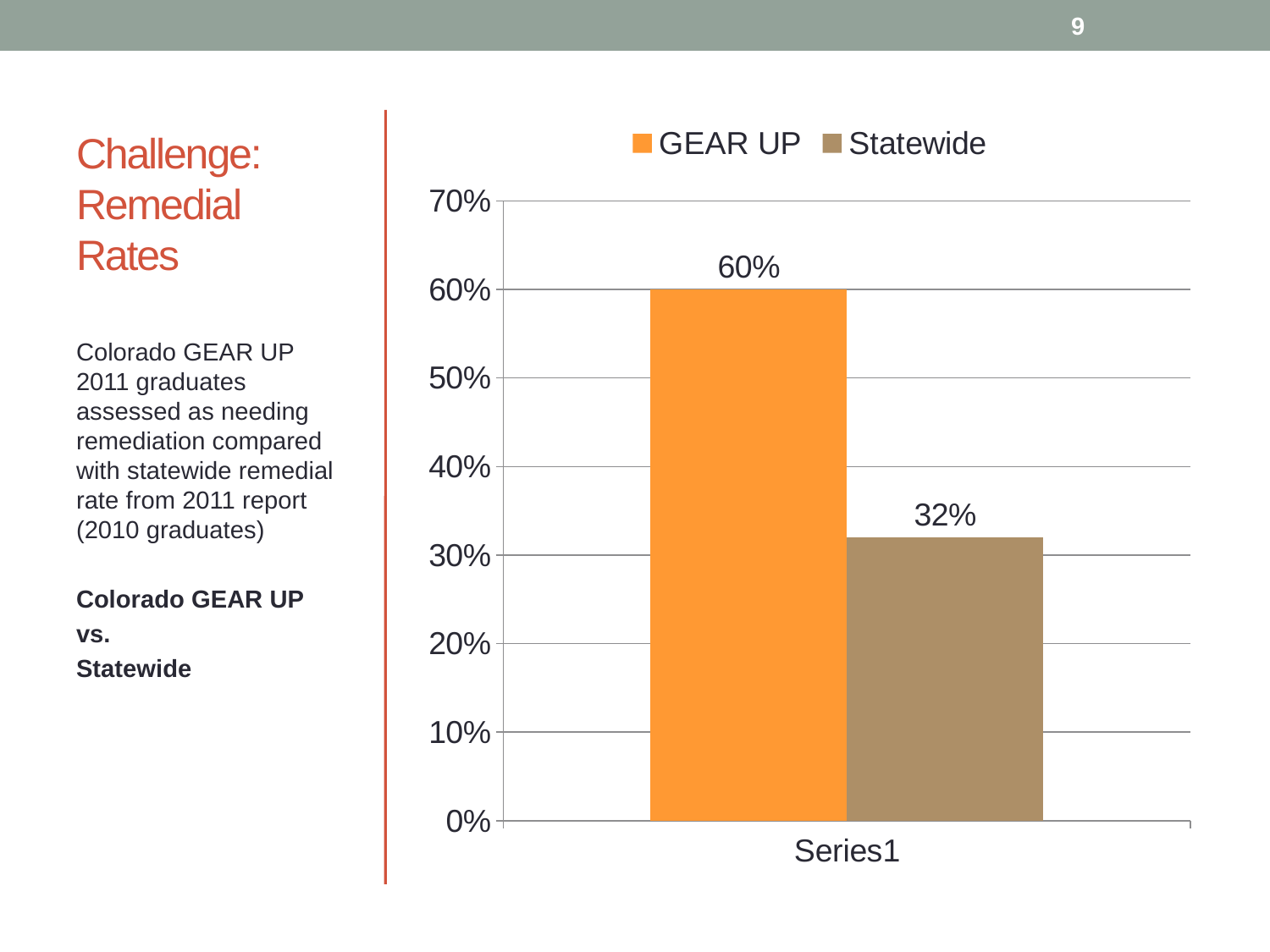
What is the value for Statewide? 32% What is the difference between the GEAR UP value and the Statewide value? 28% What is the value for GEAR UP? 60% How many bars are plotted in the chart? 2 Is the value for Statewide greater or less than 40%? less What colour is the GEAR UP bar? orange Which series has the higher value, GEAR UP or Statewide? GEAR UP What kind of chart is shown on the slide? bar chart Is the value for GEAR UP greater or less than 50%? greater What is the label shown on the x axis under the bars? Series1 Which series has the lowest value? Statewide How many series does the legend list? 2